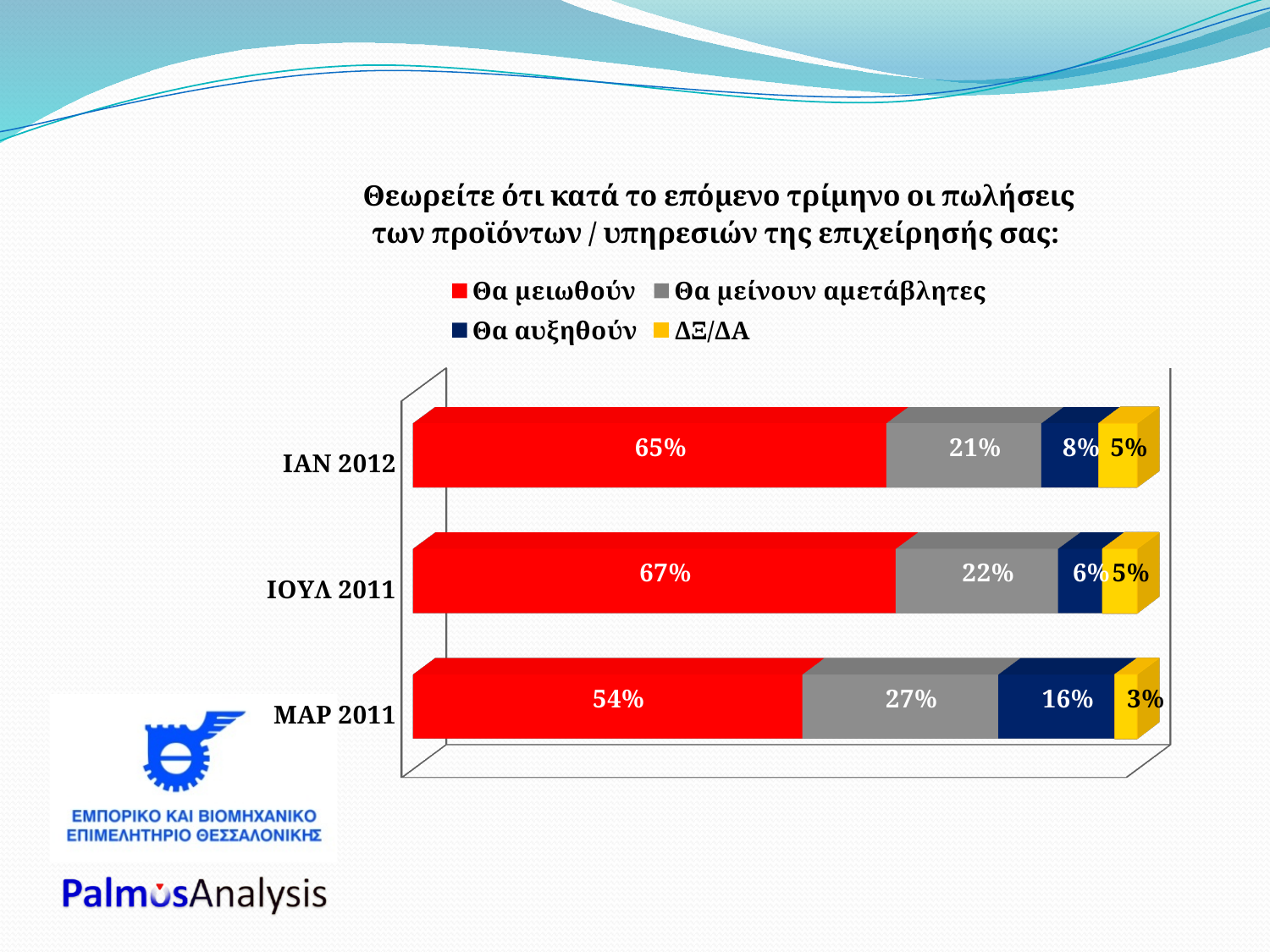
Which series is shown in red in the legend? Θα μειωθούν How many categories (time periods) are shown on the chart? 3 Which is larger: 'Θα μείνουν αμετάβλητες' in ΜΑΡ 2011 or in ΙΑΝ 2012? ΜΑΡ 2011 What is the difference between the 'Θα μειωθούν' values for ΙΟΥΛ 2011 and ΜΑΡ 2011? 13% What is the value for 'ΔΞ/ΔΑ' in ΜΑΡ 2011? 3% What is the value for 'Θα αυξηθούν' in ΜΑΡ 2011? 16% In which period is the 'Θα μειωθούν' share highest? ΙΟΥΛ 2011 In which period is the 'Θα αυξηθούν' share lowest? ΙΟΥΛ 2011 What is the value for 'Θα μείνουν αμετάβλητες' in ΙΟΥΛ 2011? 22% How many series does the legend list? 4 What is the value for 'Θα μειωθούν' in ΙΑΝ 2012? 65% What kind of chart is shown on the slide? Stacked bar chart